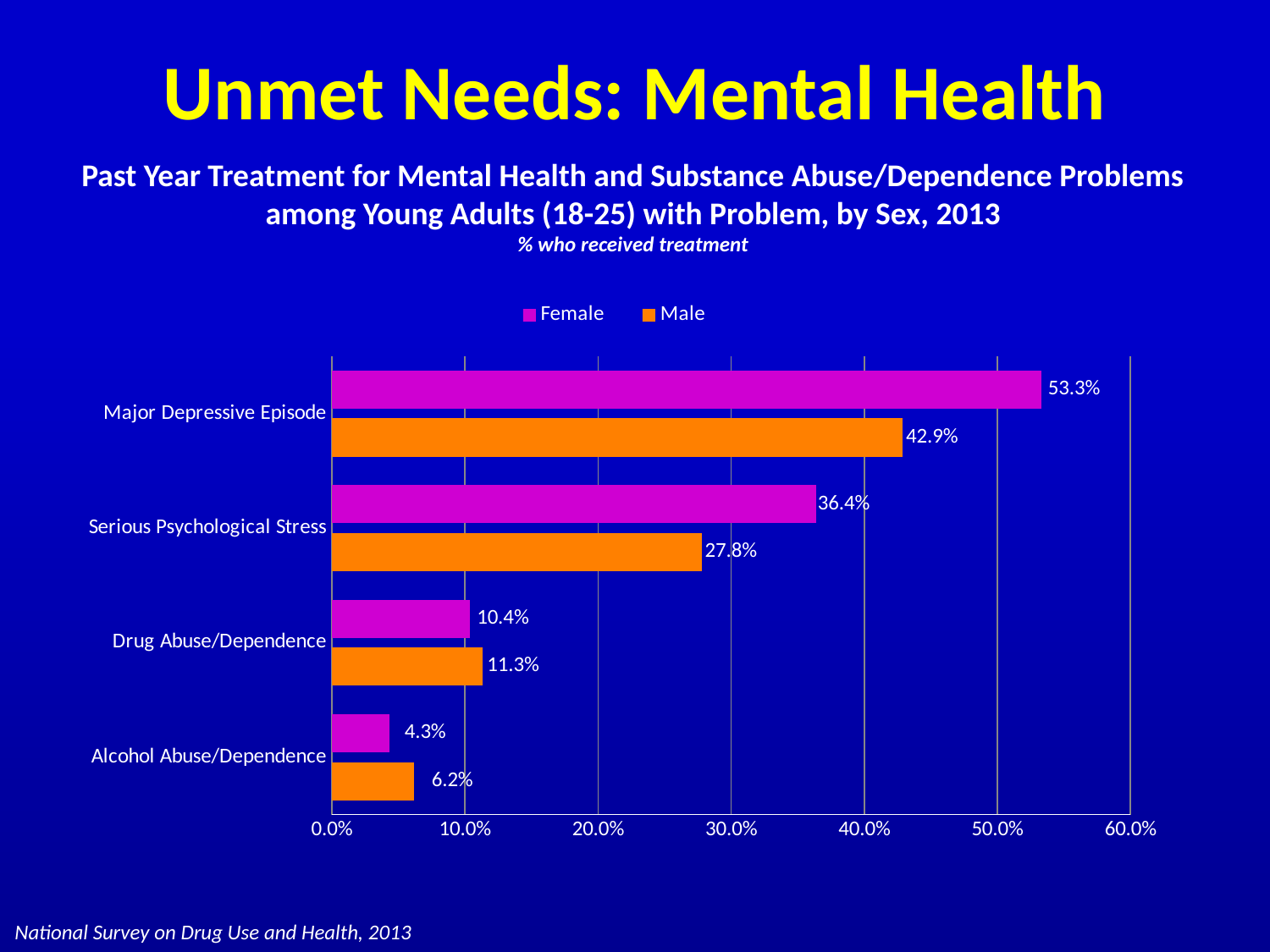
What kind of chart is shown on the slide? Bar chart What is the difference between the Female and Male values for Major Depressive Episode? 10.4% For Drug Abuse/Dependence, which is larger, the Female value or the Male value? Male How many categories are shown on the chart? 4 Which colour represents the Male series? Orange How many series does the legend list? 2 What is the value for males with Alcohol Abuse/Dependence? 6.2% What percentage of males with Serious Psychological Stress received treatment? 27.8% Is the Female value for Serious Psychological Stress greater or less than 30.0%? greater Which category has the lowest value for the Male series? Alcohol Abuse/Dependence What percentage of females with a Major Depressive Episode received treatment? 53.3% Which category has the highest value for the Female series? Major Depressive Episode